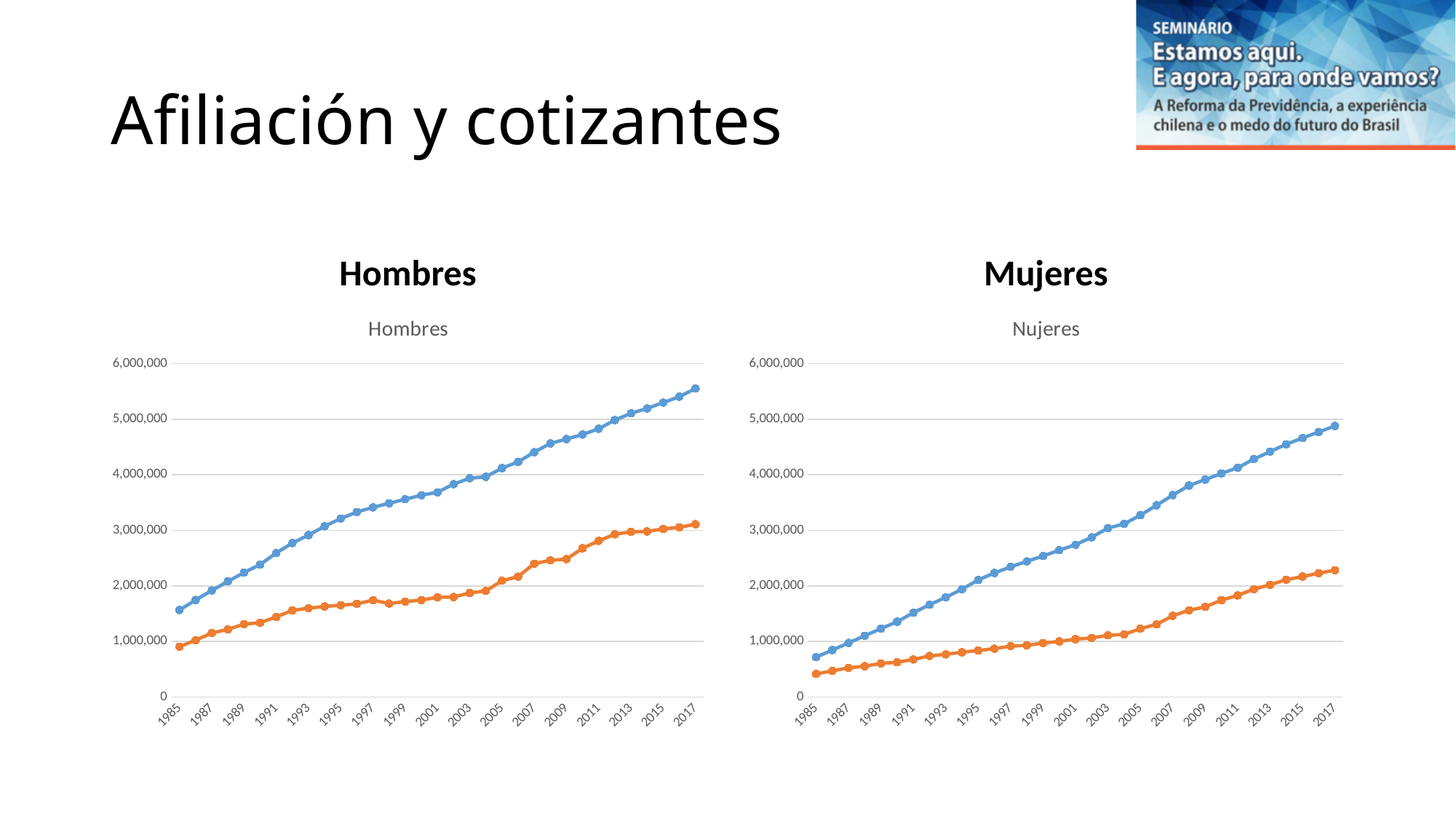
In the Hombres chart, is the value of the blue line in 2017 greater or less than 5,000,000? greater What kind of chart is the Hombres chart? line chart In the Hombres chart, does the blue line rise or fall from 1985 to 2017? rise In the Mujeres chart, does the orange line rise or fall from 1985 to 2017? rise In the Mujeres chart, is the value of the blue line in 2017 greater or less than 5,000,000? less In the Hombres chart, which line has the higher value in 2017, the blue line or the orange line? the blue line Which chart shows the higher value for the blue line in 2017, Hombres or Mujeres? Hombres In the Hombres chart, is the value of the orange line in 2007 greater or less than 2,000,000? greater In the Mujeres chart, in which year does the blue line reach its highest value? 2017